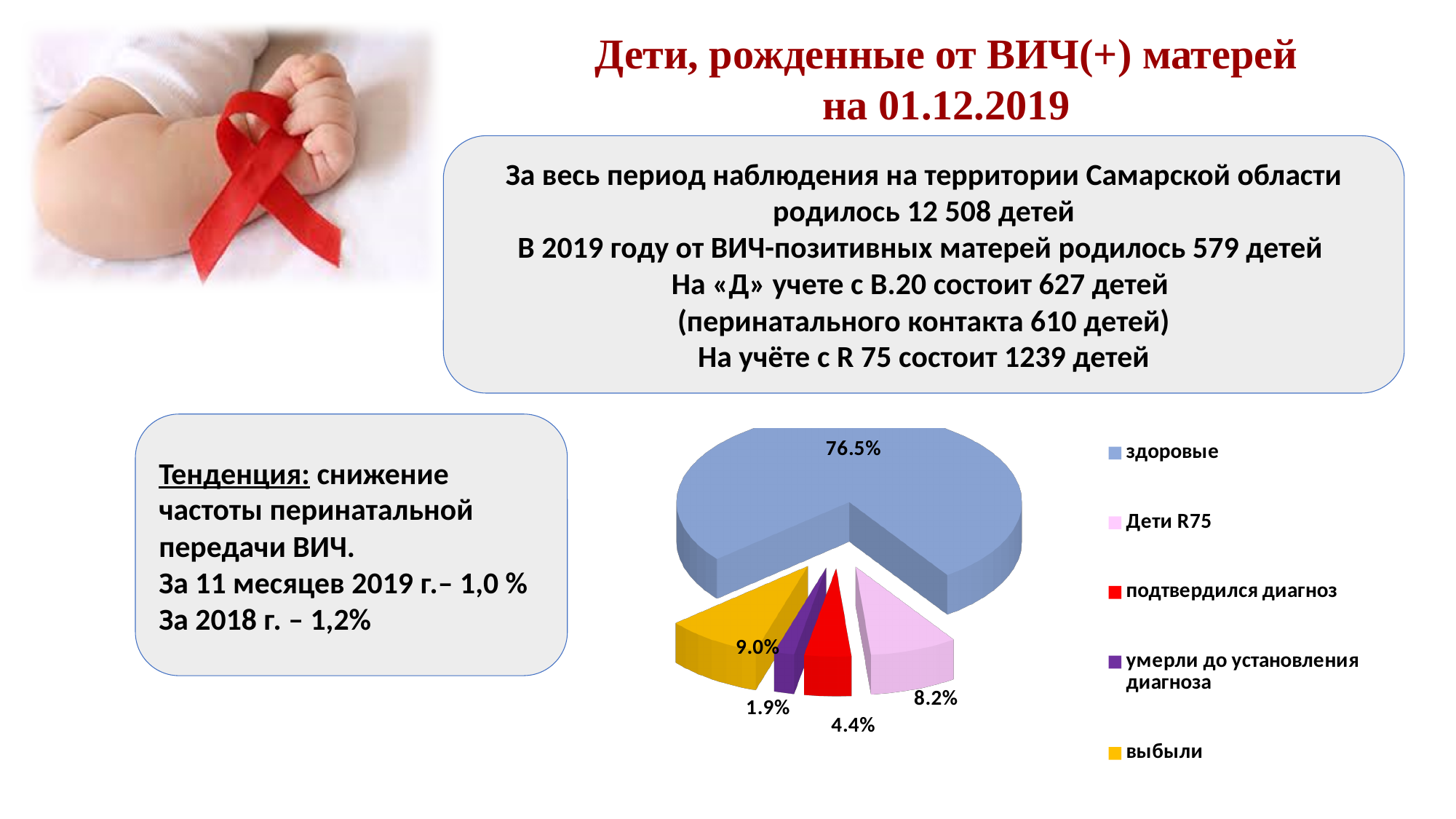
Which is larger in the pie chart: "подтвердился диагноз" or "Дети R75"? Дети R75 Which category has the smallest slice in the pie chart? умерли до установления диагноза What percentage does the pie chart show for "умерли до установления диагноза"? 1.9% What percentage does the pie chart show for "выбыли"? 9.0% What type of chart is shown on the slide? Pie chart What is the difference in percentage points between "выбыли" and "Дети R75"? 0.8 How many slices does the pie chart have? 5 What share of the pie chart is labelled "здоровые"? 76.5% What colour is the "выбыли" slice in the pie chart? Yellow What percentage does the pie chart show for "Дети R75"? 8.2% Which category has the largest slice in the pie chart? здоровые What percentage does the pie chart show for "подтвердился диагноз"? 4.4%